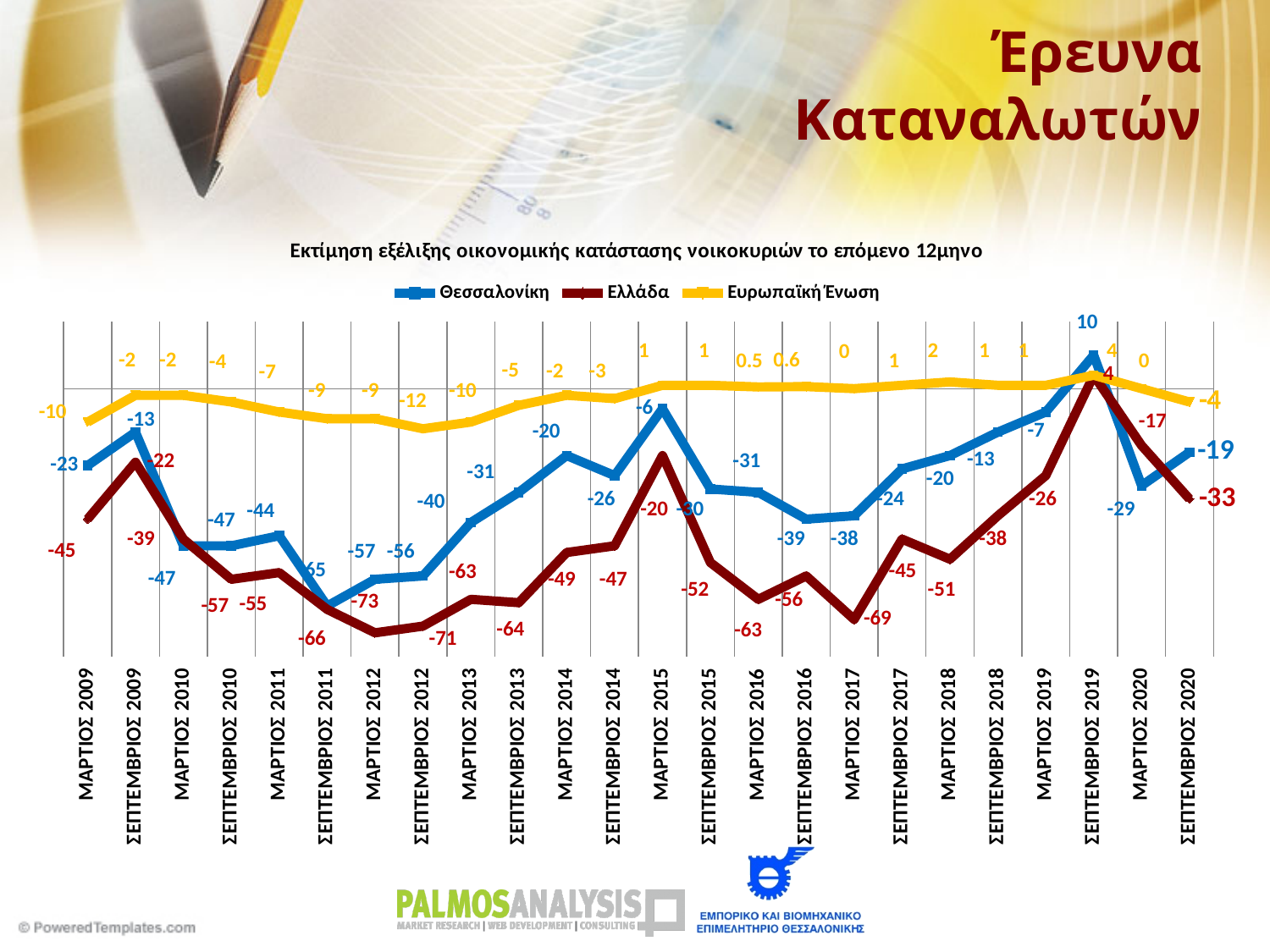
In which period does Ελλάδα reach its lowest value? ΜΑΡΤΙΟΣ 2012 What type of chart is shown on the slide? Line chart How many series does the legend list? 3 In ΜΑΡΤΙΟΣ 2009, which is higher: Θεσσαλονίκη or Ελλάδα? Θεσσαλονίκη In which period does Θεσσαλονίκη reach its highest value? ΣΕΠΤΕΜΒΡΙΟΣ 2019 What is the lowest value plotted for Θεσσαλονίκη? -65 What is the value for Θεσσαλονίκη in ΣΕΠΤΕΜΒΡΙΟΣ 2020? -19 What is the value for Ευρωπαϊκή Ένωση in ΣΕΠΤΕΜΒΡΙΟΣ 2020? -4 How many time points are plotted along the x axis? 24 What is the value for Ελλάδα in ΣΕΠΤΕΜΒΡΙΟΣ 2020? -33 What is the title of the chart? Εκτίμηση εξέλιξης οικονομικής κατάστασης νοικοκυριών το επόμενο 12μηνο What is the difference between the Θεσσαλονίκη and Ελλάδα values in ΣΕΠΤΕΜΒΡΙΟΣ 2020? 14